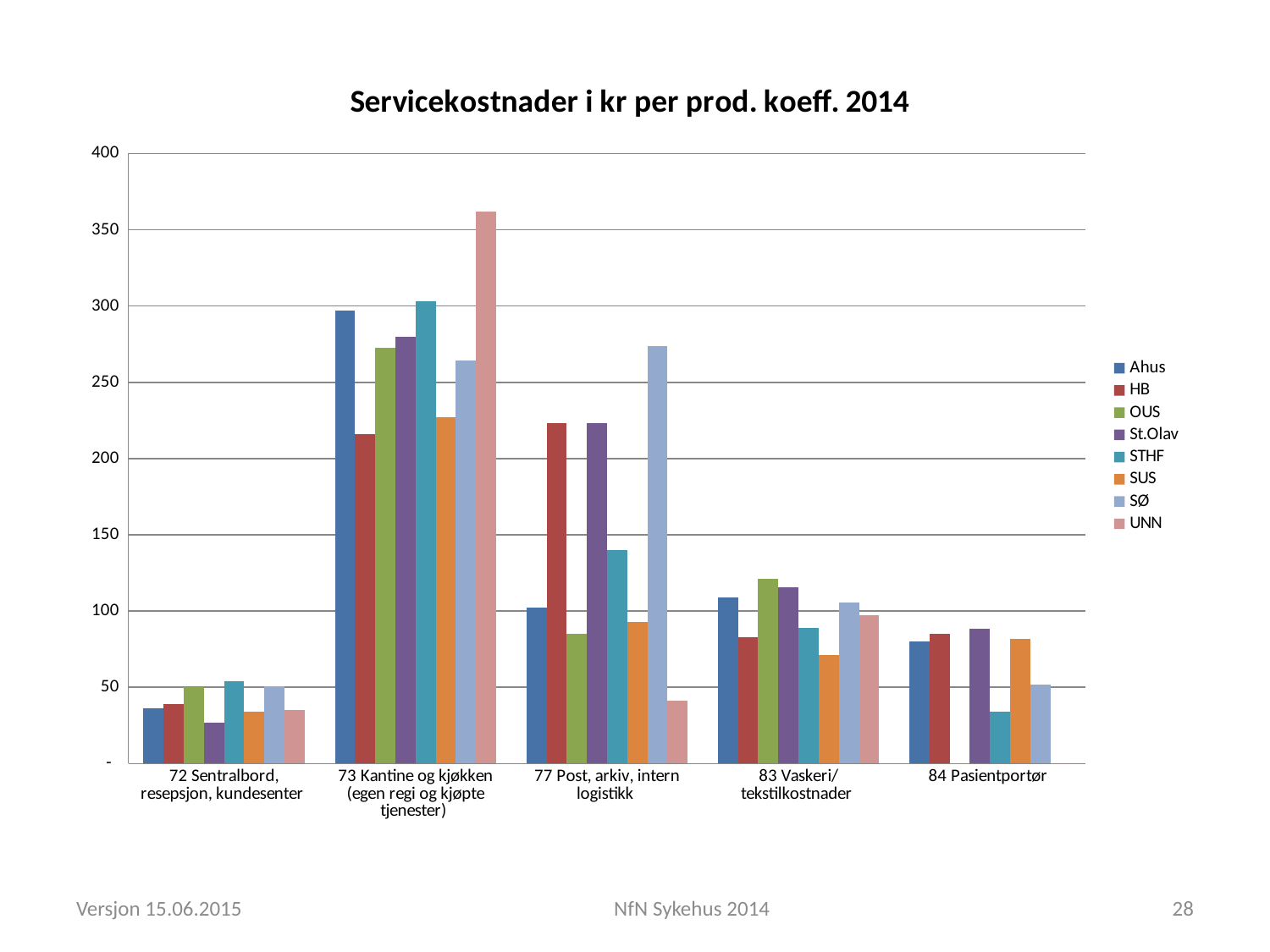
What kind of chart is shown on the slide? bar chart In the category '77 Post, arkiv, intern logistikk', which is larger, STHF or SUS? STHF In the category '73 Kantine og kjøkken (egen regi og kjøpte tjenester)', which series has the highest value? UNN In the category '77 Post, arkiv, intern logistikk', which series has the highest value? SØ Is the value for SØ in '77 Post, arkiv, intern logistikk' greater or less than 250? greater How many categories are shown on the x axis? 5 What is the title of the chart? Servicekostnader i kr per prod. koeff. 2014 Is the value for STHF in '84 Pasientportør' greater or less than 50? less In the category '77 Post, arkiv, intern logistikk', which series has the lowest value? UNN In the category '73 Kantine og kjøkken (egen regi og kjøpte tjenester)', which is larger, Ahus or HB? Ahus How many series does the legend list? 8 Is the value for UNN in '73 Kantine og kjøkken (egen regi og kjøpte tjenester)' greater or less than 350? greater